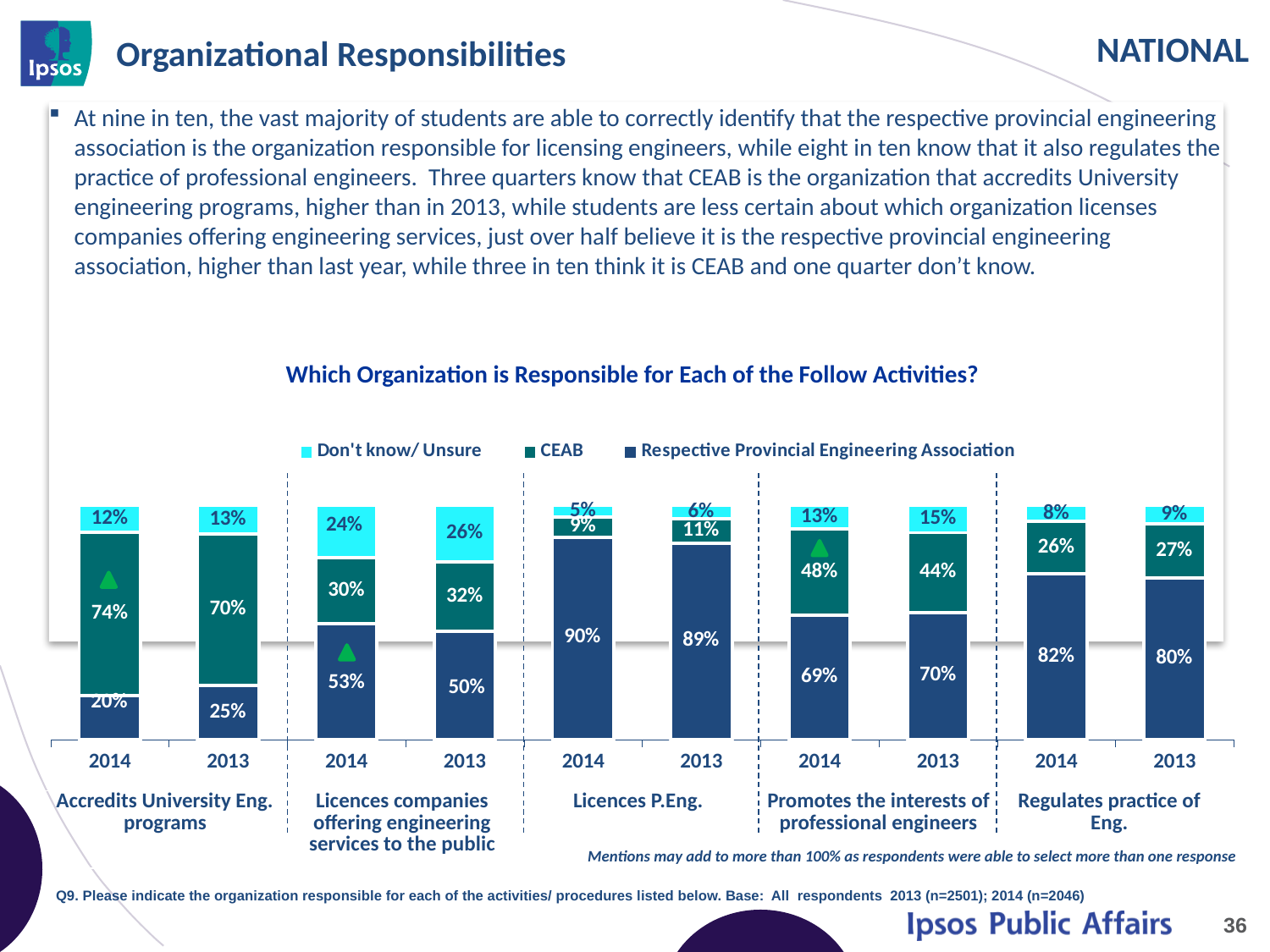
What kind of chart is shown on the slide? stacked bar chart What percentage of students in 2013 said the Respective Provincial Engineering Association licences companies offering engineering services to the public? 50% How many series does the legend list? 3 Which series is shown in the darkest blue colour in the legend? Respective Provincial Engineering Association What percentage of students in 2014 said CEAB accredits University Eng. programs? 74% What is the Don't know/Unsure value for Licences P.Eng. in 2014? 5% What is the Respective Provincial Engineering Association value for Regulates practice of Eng. in 2014? 82% Across all bars, which activity and year has the highest Respective Provincial Engineering Association value? Licences P.Eng., 2014 What percentage of students in 2013 said CEAB promotes the interests of professional engineers? 44% For Licences companies offering engineering services to the public, is the Don't know/Unsure value larger in 2014 or 2013? 2013 What is the difference between the 2014 and 2013 CEAB values for Accredits University Eng. programs? 4% Which activity has the lowest Don't know/Unsure value in 2014? Licences P.Eng.